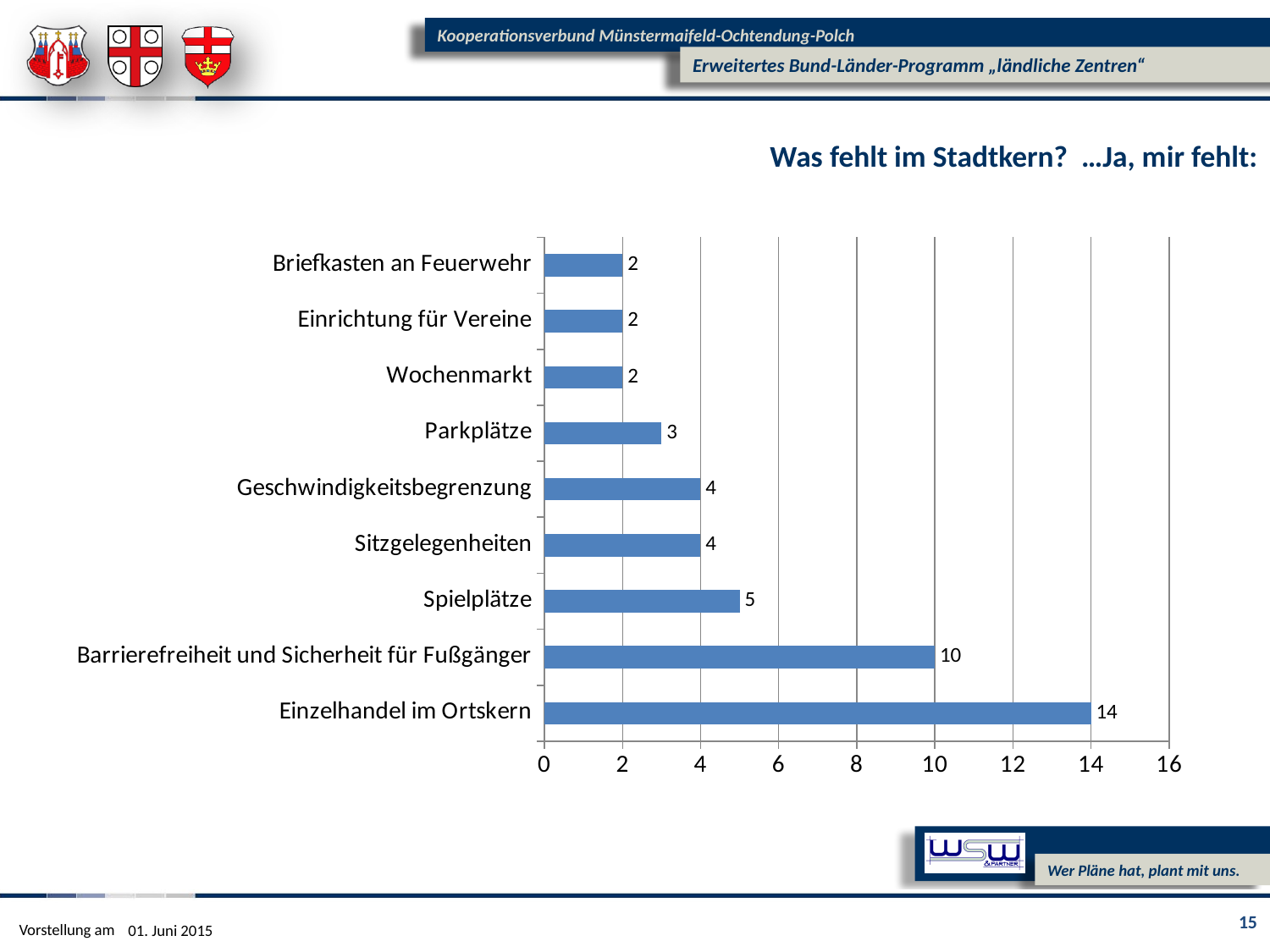
What kind of chart is shown on the slide? Bar chart What is the title shown above the chart? Was fehlt im Stadtkern? …Ja, mir fehlt: Which is larger, the value for Spielplätze or the value for Sitzgelegenheiten? Spielplätze How many categories have a value of 2? 3 Which category has the highest value? Einzelhandel im Ortskern What is the value for Spielplätze? 5 What is the value for Einzelhandel im Ortskern? 14 What is the value for Parkplätze? 3 What is the value for Barrierefreiheit und Sicherheit für Fußgänger? 10 How many categories are shown in the chart? 9 What is the difference between the values for Geschwindigkeitsbegrenzung and Wochenmarkt? 2 What is the difference between the values for Einzelhandel im Ortskern and Barrierefreiheit und Sicherheit für Fußgänger? 4